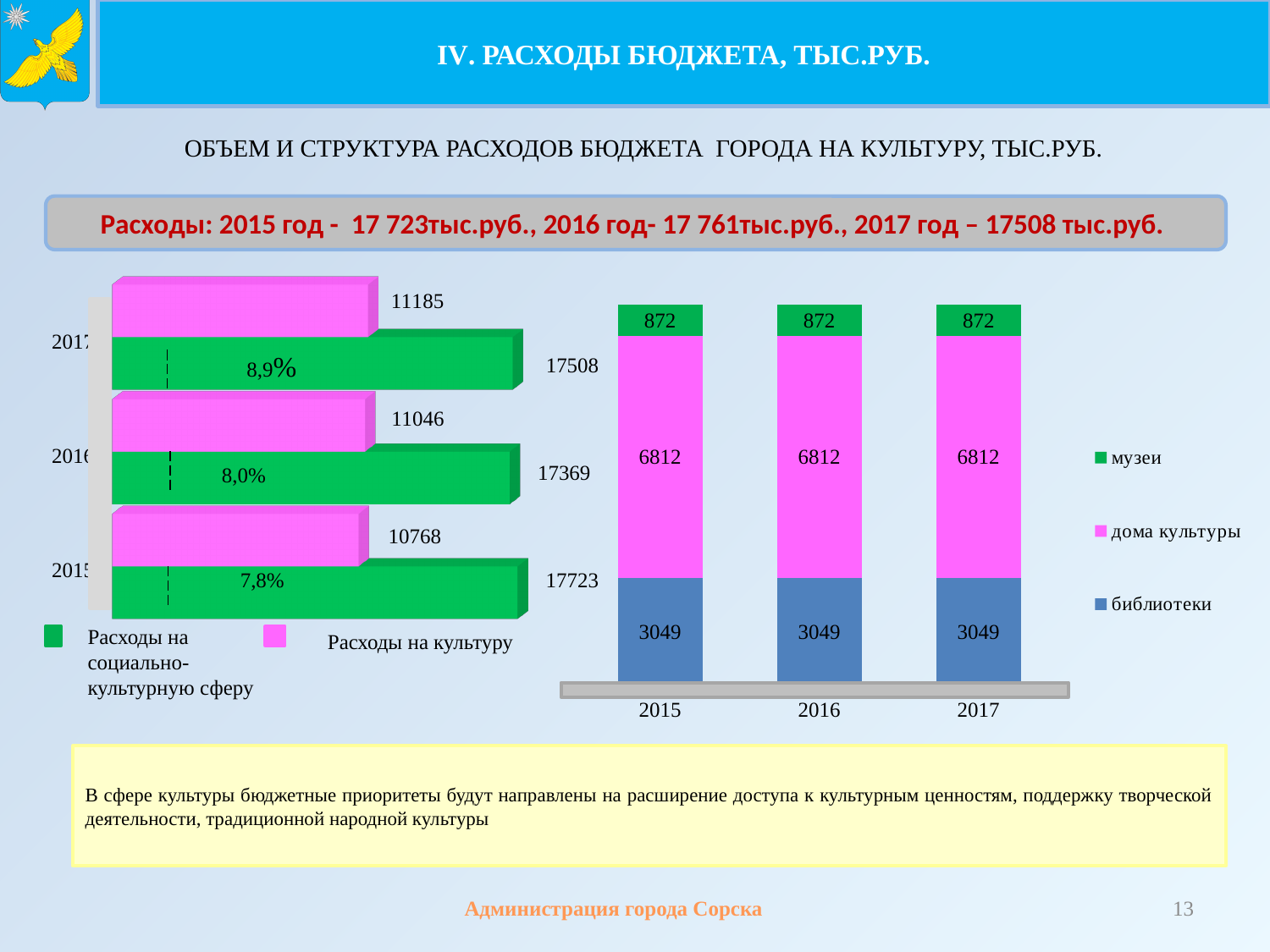
In the left chart, what is the difference between 'Расходы на культуру' in 2017 and in 2015? 417 How many series does the legend of the right stacked chart list? 3 In the left chart, what is the value for 'Расходы на культуру' in 2016? 11046 In the right stacked chart, what is the total of the 2015 bar? 10733 In the left chart, what is the value for 'Расходы на культуру' in 2017? 11185 In the right stacked chart, what is the value for 'музеи' in 2016? 872 In the left chart, what percentage is shown on the 2016 bar? 8,0% In the right stacked chart, what is the value for 'библиотеки' in 2017? 3049 What kind of chart is the right chart? Stacked bar chart In the left chart, what is the value for 'Расходы на социально-культурную сферу' in 2015? 17723 In the left chart, which year has the highest value for 'Расходы на культуру'? 2017 In the left chart, which year has the lowest value for 'Расходы на социально-культурную сферу'? 2016